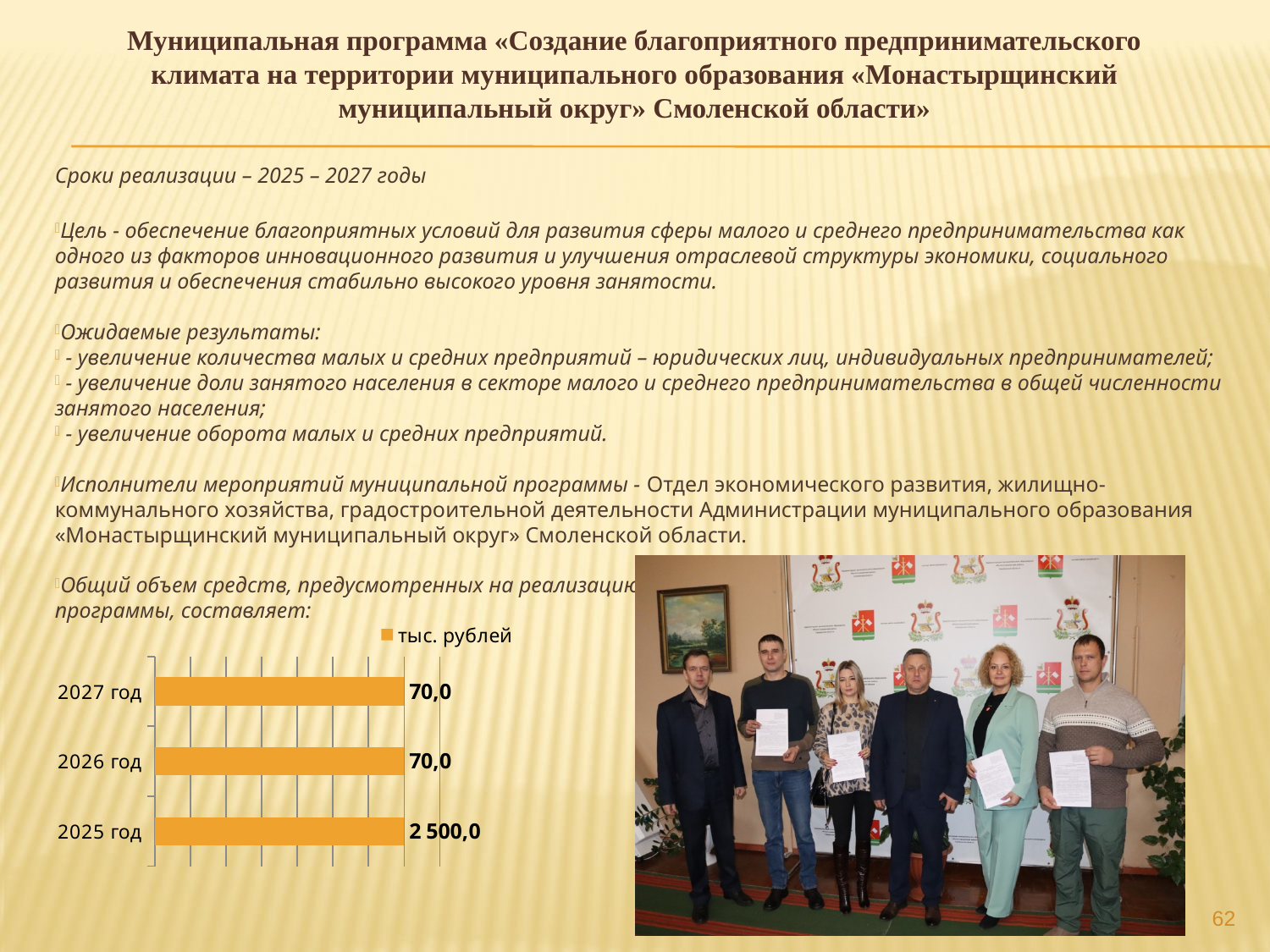
What is the legend entry of the chart? тыс. рублей What is the value for 2027 год? 70,0 What kind of chart is shown on the slide? bar chart Are the values for 2026 год and 2027 год equal? Yes How many categories are shown in the chart? 3 What is the value for 2025 год? 2 500,0 What is the value for 2026 год? 70,0 How many series does the legend list? 1